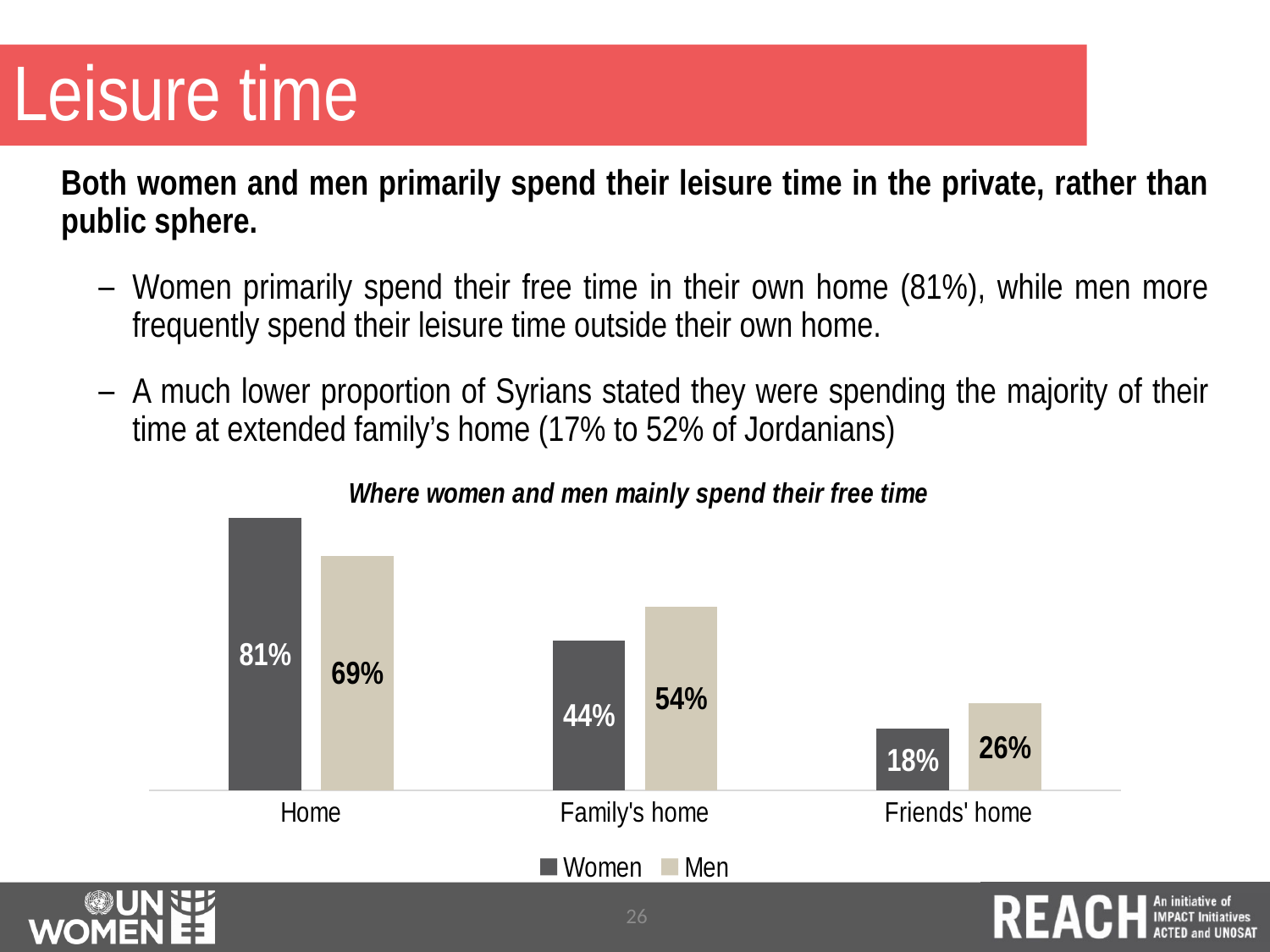
What is the title of the chart? Where women and men mainly spend their free time What kind of chart is shown on the slide? Bar chart How many series does the legend list? 2 What percentage of men mainly spend their free time at family's home? 54% Which category has the lowest value for men? Friends' home How many categories are shown on the x axis? 3 Which is larger at family's home: the value for women or for men? Men What is the value for men at friends' home? 26% Which category has the highest value for women? Home What percentage of women mainly spend their free time at home? 81% What is the difference between men and women for the Friends' home category? 8% What is the difference between women and men for the Home category? 12%